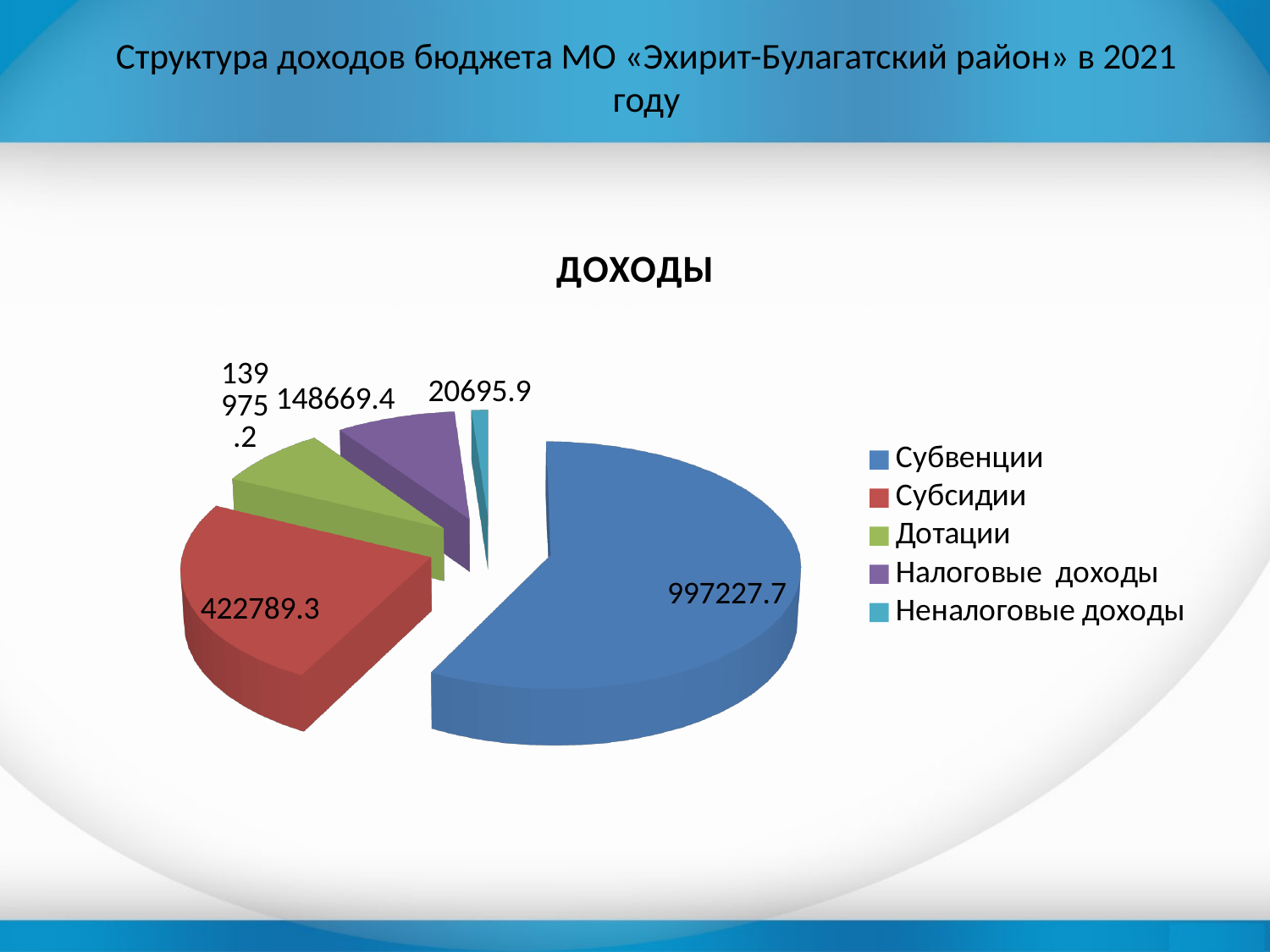
What is the value for Неналоговые доходы? 20695.9 What is the title of the chart? ДОХОДЫ Which colour represents Субсидии in the chart? Red What is the value for Субсидии? 422789.3 Which category has the smallest slice? Неналоговые доходы How many categories does the legend list? 5 What is the difference between the values for Субвенции and Субсидии? 574438.4 Which is larger, Налоговые доходы or Дотации? Налоговые доходы What is the value for Субвенции? 997227.7 What type of chart is shown on the slide? Pie chart What is the value for Налоговые доходы? 148669.4 Which category has the largest slice? Субвенции